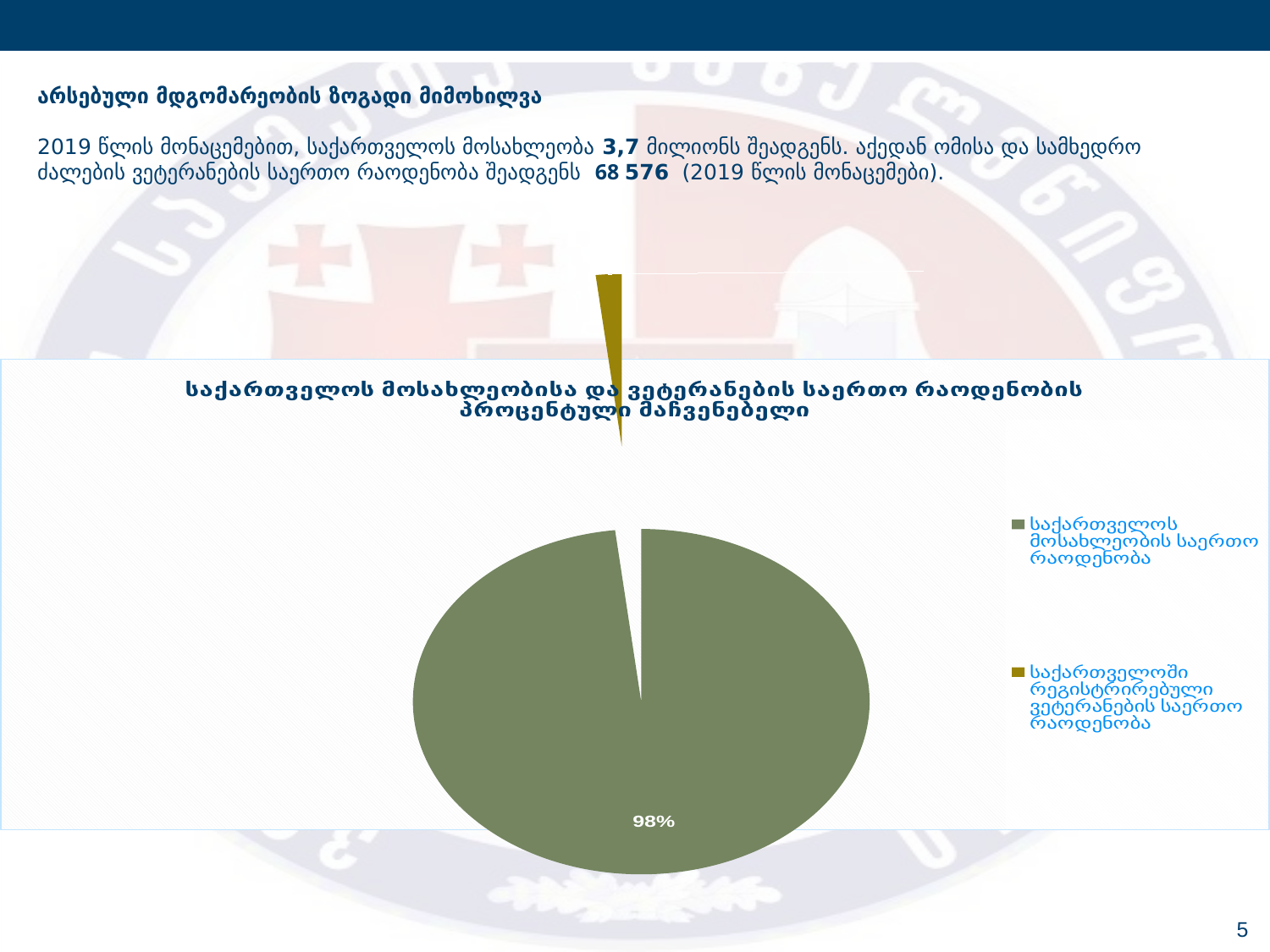
What kind of chart is shown on the slide? pie chart How many entries does the legend of the pie chart list? 2 Which category has the largest slice in the pie chart? საქართველოს მოსახლეობის საერთო რაოდენობა What colour is the slice for საქართველოს მოსახლეობის საერთო რაოდენობა? green Is the share for საქართველოს მოსახლეობის საერთო რაოდენობა greater or less than 50%? greater How many slices does the pie chart have? 2 Which category has the smallest slice in the pie chart? საქართველოში რეგისტრირებული ვეტერანების საერთო რაოდენობა Which is larger in the pie chart: the slice for საქართველოს მოსახლეობის საერთო რაოდენობა or the slice for საქართველოში რეგისტრირებული ვეტერანების საერთო რაოდენობა? საქართველოს მოსახლეობის საერთო რაოდენობა What share of the pie does the slice for საქართველოს მოსახლეობის საერთო რაოდენობა represent? 98% What is the title of the pie chart? საქართველოს მოსახლეობისა და ვეტერანების საერთო რაოდენობის პროცენტული მაჩვენებელი